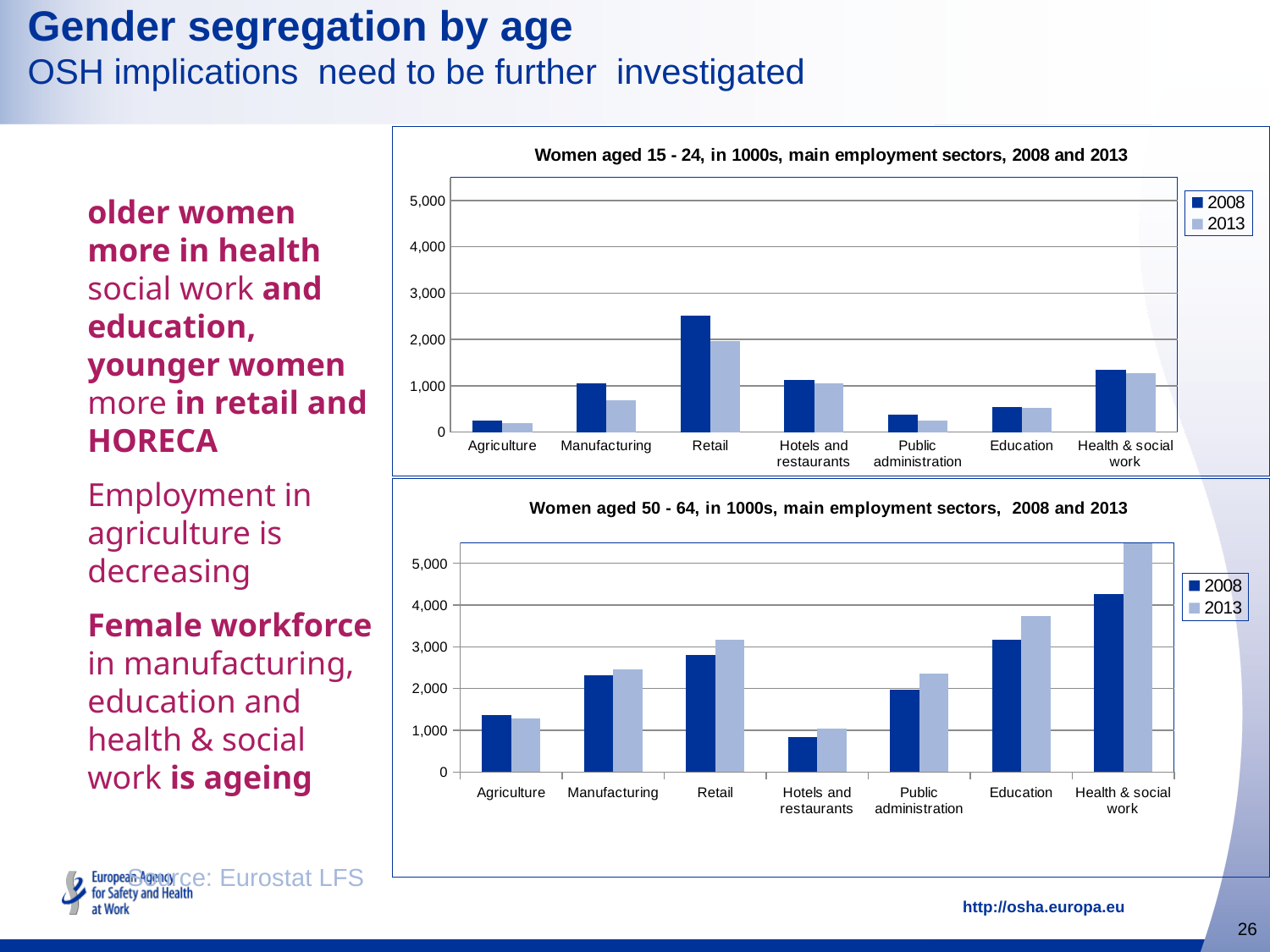
How many series does the legend of the chart titled 'Women aged 15 - 24' list? 2 In the chart titled 'Women aged 50 - 64', is the 2013 value for Health & social work greater or less than 5,000? greater How many employment sectors are shown on the x axis of the chart titled 'Women aged 50 - 64'? 7 In the chart titled 'Women aged 50 - 64', which sector has the highest value for 2013? Health & social work What kind of chart is the chart titled 'Women aged 50 - 64'? Bar chart In the chart titled 'Women aged 15 - 24', which is larger for Retail: the 2008 value or the 2013 value? 2008 In the chart titled 'Women aged 50 - 64', which is larger for Education: the 2008 value or the 2013 value? 2013 In the chart titled 'Women aged 15 - 24', which sector has the highest value for 2008? Retail In the chart titled 'Women aged 50 - 64', which sector has the lowest value for 2008? Hotels and restaurants In the chart titled 'Women aged 15 - 24', which sector has the lowest value for 2013? Agriculture In the chart titled 'Women aged 15 - 24', is the 2008 value for Retail greater or less than 2,000? greater In the chart titled 'Women aged 15 - 24', is the 2013 value for Manufacturing greater or less than 1,000? less